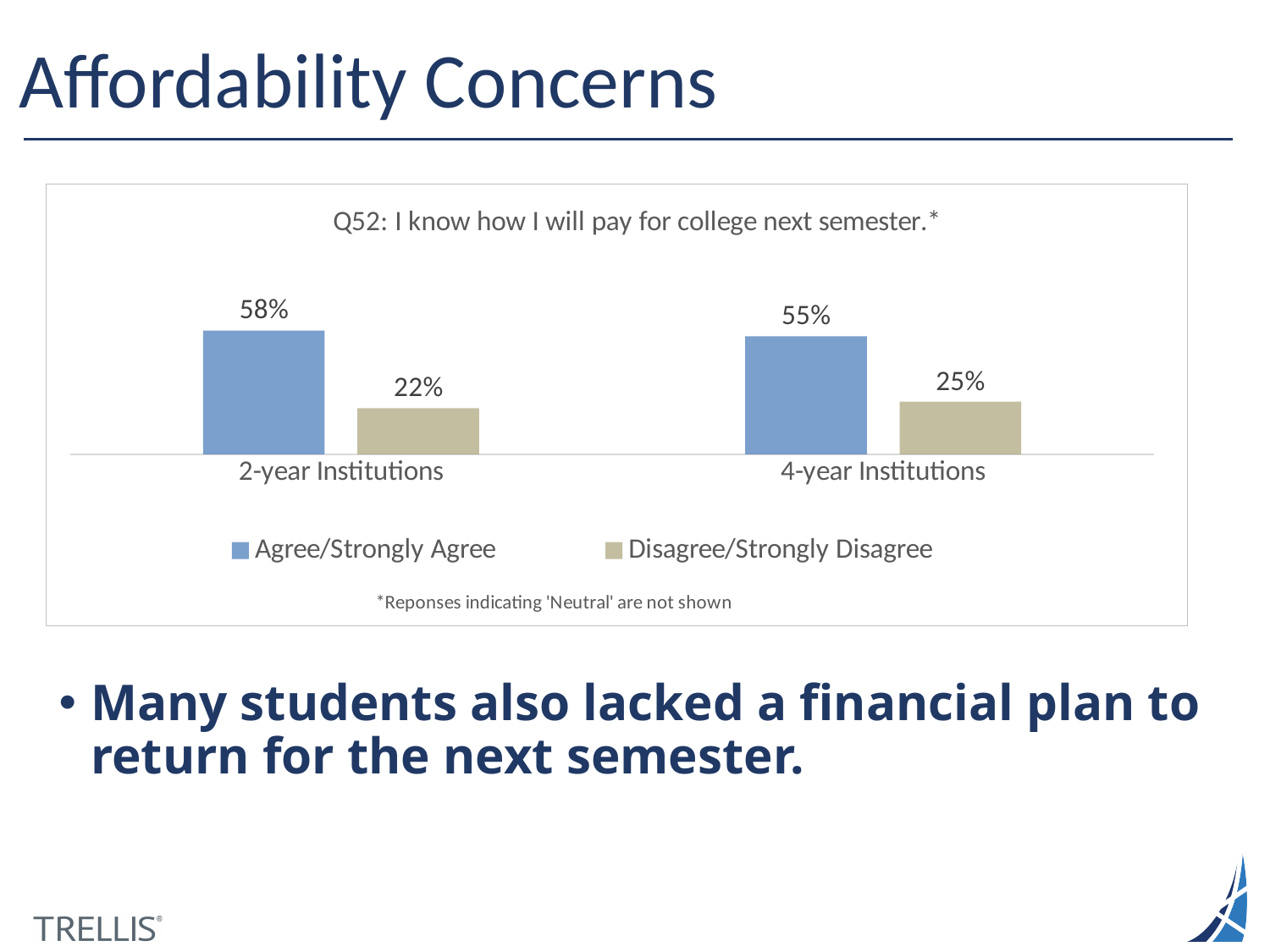
How much higher is the Agree/Strongly Agree percentage for 2-year institutions than for 4-year institutions? 3 percentage points How many institution categories are shown on the x axis? 2 What is the Agree/Strongly Agree value for 4-year institutions? 55% Which institution type has the lower Disagree/Strongly Disagree percentage? 2-year Institutions Is the Disagree/Strongly Disagree value larger for 2-year or 4-year institutions? 4-year Institutions What percentage of students at 2-year institutions agree or strongly agree that they know how they will pay for college next semester? 58% What type of chart is shown on the slide? Bar chart What percentage of students at 4-year institutions disagree or strongly disagree that they know how they will pay for college next semester? 25% Which institution type has the higher Agree/Strongly Agree percentage? 2-year Institutions What is the difference between the Agree/Strongly Agree and Disagree/Strongly Disagree percentages for 2-year institutions? 36 percentage points How many series does the legend list? 2 What is the Disagree/Strongly Disagree value for 2-year institutions? 22%